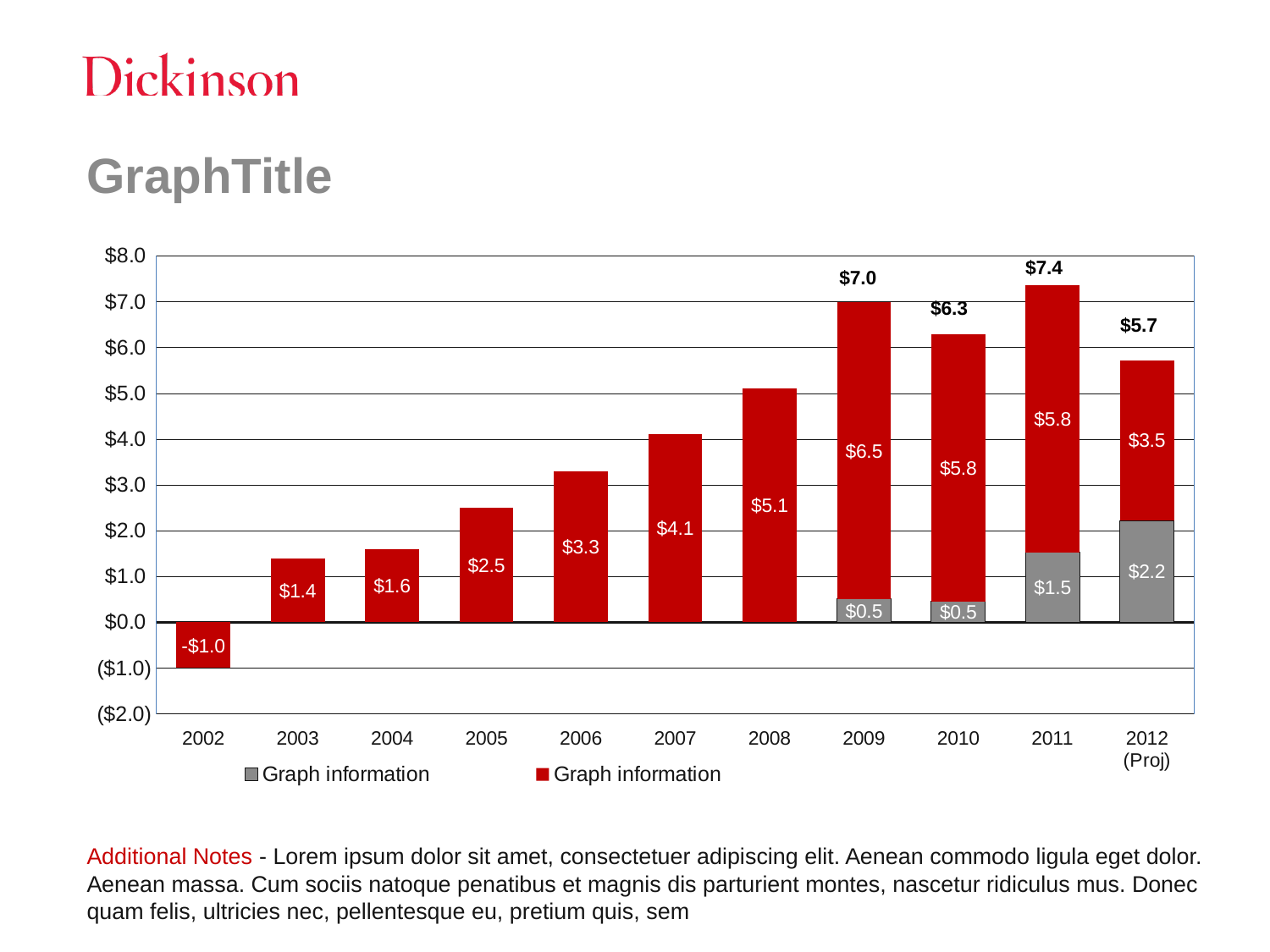
Which is larger, the value for 2005 or the value for 2004? 2005 Which year has the lowest value? 2002 What is the value of the grey segment for 2011? $1.5 What is the total of the stacked bar for 2011? $7.4 How many series does the legend list? 2 What is the difference between the red segment values for 2009 and 2010? $0.7 Which year has the highest total bar? 2011 What kind of chart is shown on the slide? Stacked bar chart What is the total of the stacked bar for 2012 (Proj)? $5.7 What is the value of the red segment for 2008? $5.1 What is the value of the red segment for 2012 (Proj)? $3.5 How many years are shown on the x axis? 11